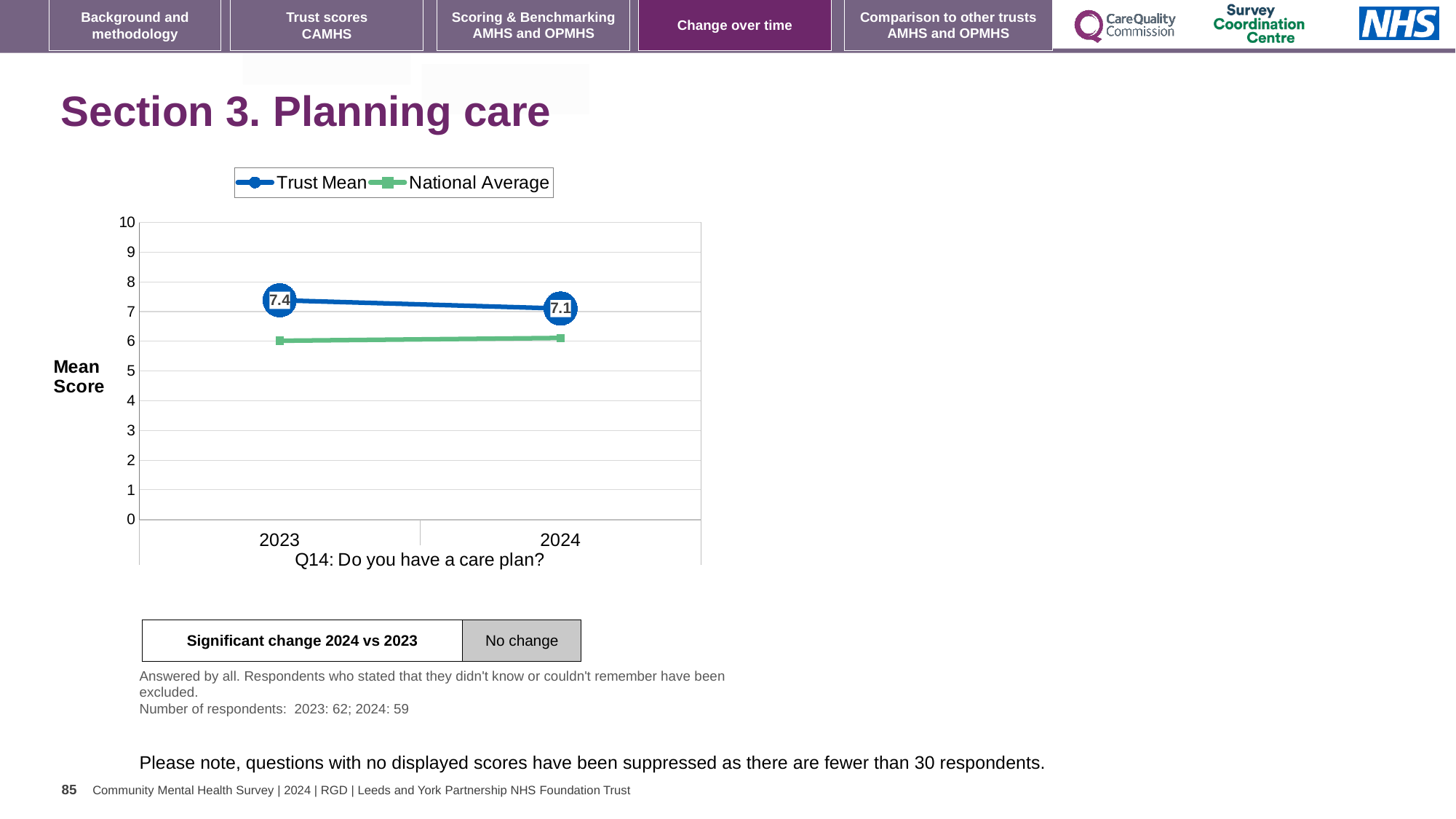
Is the National Average value for 2023 greater or less than 7? less How many series does the legend list? 2 In which year is the Trust Mean lowest? 2024 How many years are plotted on the x axis? 2 What is the difference between the Trust Mean in 2023 and in 2024? 0.3 Which is larger in 2024, the Trust Mean or the National Average? Trust Mean Does the Trust Mean rise or fall from 2023 to 2024? fall In which year is the Trust Mean highest? 2023 What is the Trust Mean value for 2023? 7.4 What kind of chart is shown on the slide? line chart Is the National Average value for 2024 greater or less than 5? greater What is the Trust Mean value for 2024? 7.1